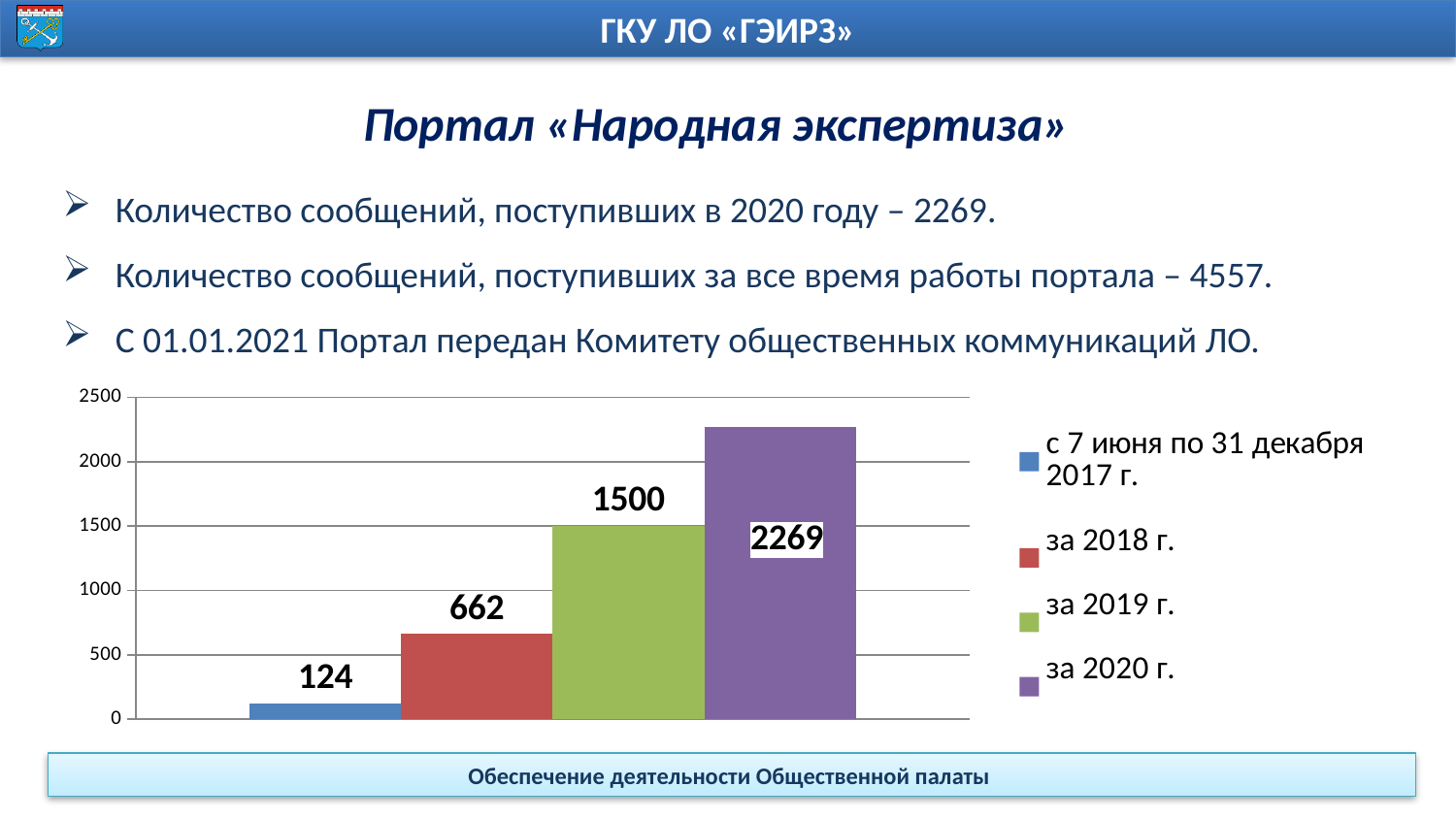
Which legend entry has the lowest value in the bar chart? с 7 июня по 31 декабря 2017 г. What kind of chart is shown on the slide? Bar chart Which is larger in the bar chart: the value for 2018 or the value for 2019? 2019 (за 2019 г.) Do the values in the bar chart rise or fall from left to right? Rise What is the value for 2020 (за 2020 г.) in the bar chart? 2269 What is the difference between the values for 2020 and 2019 in the bar chart? 769 What is the difference between the values for 2019 and 2018 in the bar chart? 838 What is the value for 2018 (за 2018 г.) in the bar chart? 662 How many series does the legend of the bar chart list? 4 What is the value for the period from 7 June to 31 December 2017 in the bar chart? 124 Which legend entry has the highest value in the bar chart? за 2020 г. What is the value for 2019 (за 2019 г.) in the bar chart? 1500